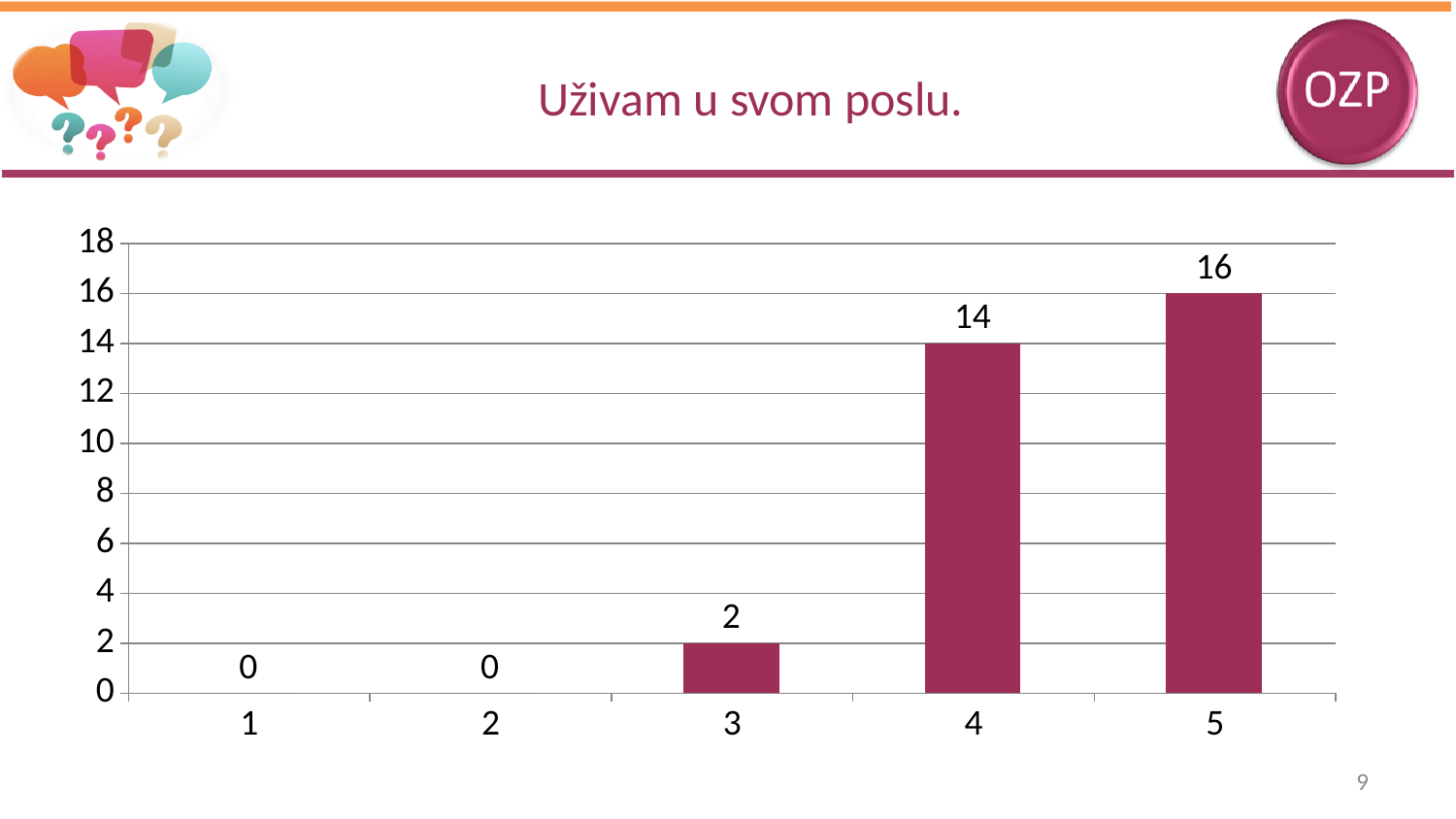
What is the value for category 1? 0 What is the difference between the values for categories 4 and 3? 12 What kind of chart is shown on the slide? bar chart Which category has the highest value? 5 Which is larger, the value for category 3 or the value for category 4? 4 What is the value for category 4? 14 Is the value for category 5 greater or less than 10? greater How many categories are shown on the x axis? 5 What is the value for category 5? 16 What is the value for category 3? 2 What is the difference between the values for categories 5 and 4? 2 Do the values rise or fall from category 1 to category 5? rise